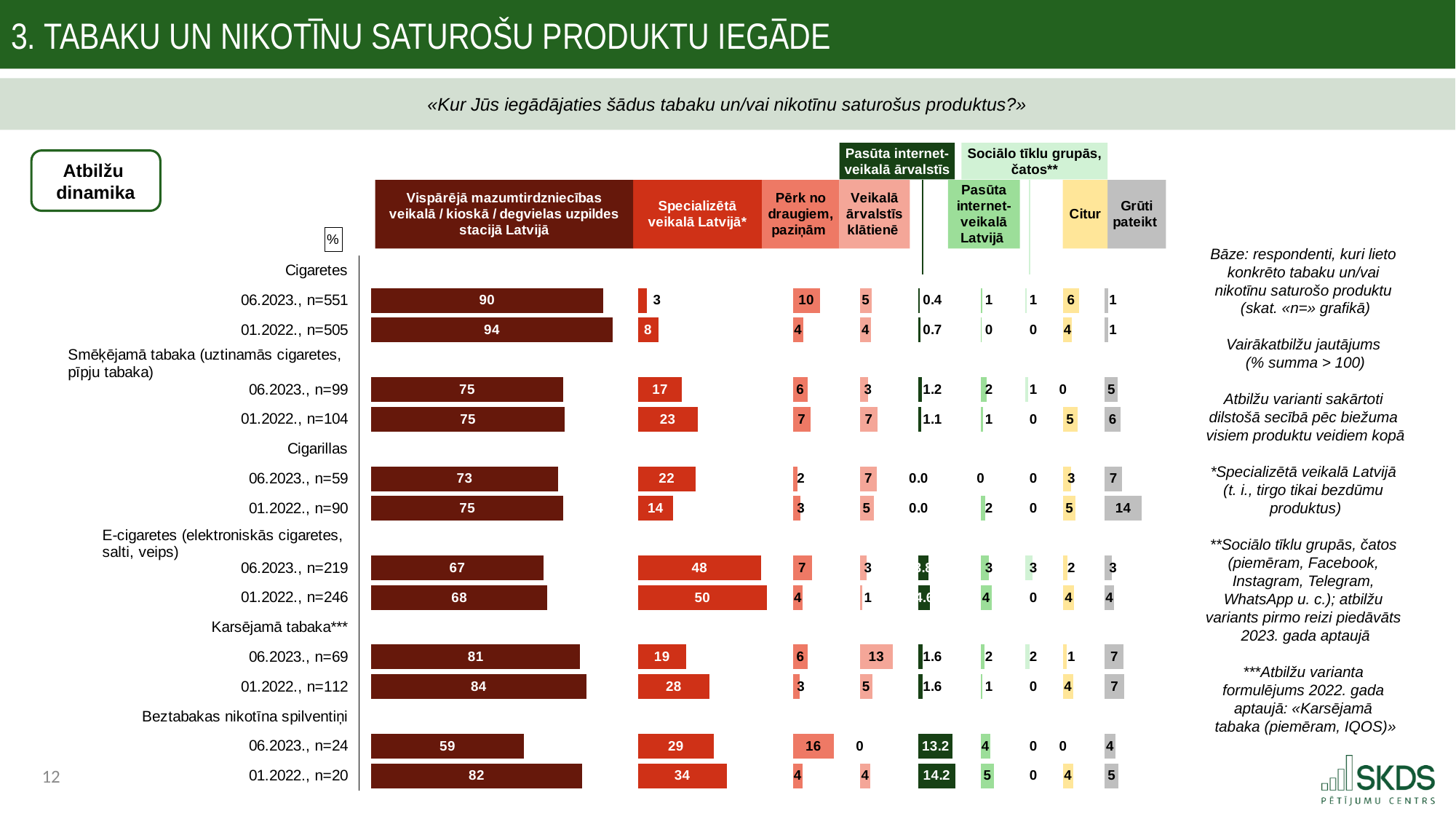
Which product row has the lowest value for Vispārējā mazumtirdzniecības veikalā / kioskā / degvielas uzpildes stacijā Latvijā? Beztabakas nikotīna spilventiņi, 06.2023., n=24 What is the value for Grūti pateikt for Cigarillas in 01.2022., n=90? 14 For Karsējamā tabaka, is the Specializētā veikalā Latvijā value larger in 06.2023., n=69 or in 01.2022., n=112? 01.2022., n=112 Which product row has the highest value for Specializētā veikalā Latvijā? E-cigaretes, 01.2022., n=246 What percentage of cigarette users (Cigaretes, 06.2023., n=551) buy in a general retail store / kiosk / fuel station in Latvia (Vispārējā mazumtirdzniecības veikalā / kioskā / degvielas uzpildes stacijā Latvijā)? 90 What is the value for Veikalā ārvalstīs klātienē for Karsējamā tabaka in 06.2023., n=69? 13 What is the difference between the Vispārējā mazumtirdzniecības veikalā values for Beztabakas nikotīna spilventiņi in 01.2022. (82) and 06.2023. (59)? 23 What is the value for Specializētā veikalā Latvijā for E-cigaretes in 01.2022., n=246? 50 How many answer-option series (columns) does the chart show? 9 How many product types are listed in the chart? 6 What kind of chart is shown on the slide? Bar chart What is the value for Pasūta internetveikalā ārvalstīs for Beztabakas nikotīna spilventiņi in 06.2023., n=24? 13.2